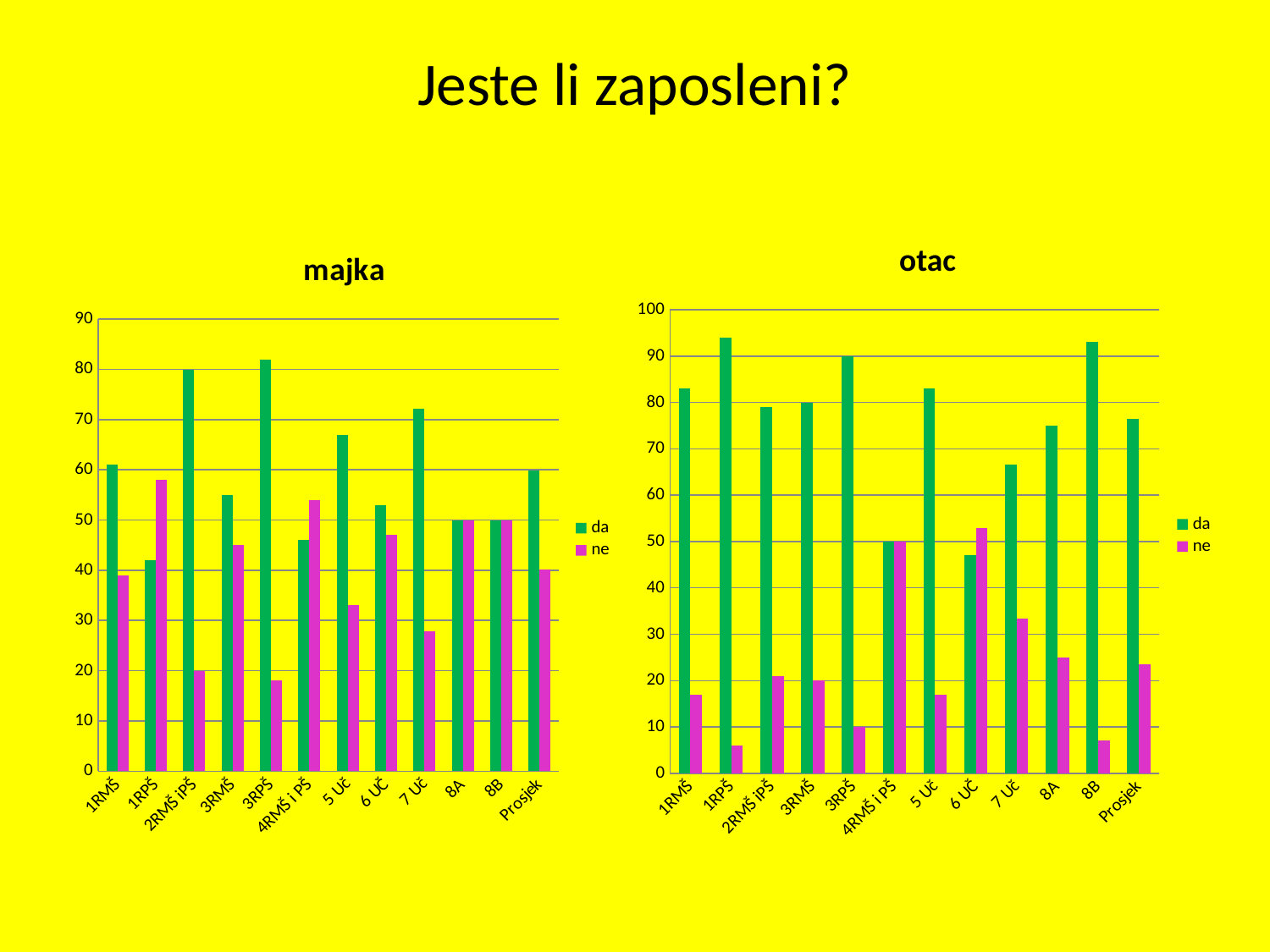
In the 'majka' chart, is the value for 'da' in 5 Uč greater or less than 70? less How many categories are shown on the x axis of the 'otac' chart? 12 How many series does the legend of the 'majka' chart list? 2 In the 'otac' chart, what is the value for 'ne' in the 3RMŠ category? 20 In the 'majka' chart, is the value for 'da' in 1RMŠ greater or less than 50? greater In the 'majka' chart, which is larger for 1RPŠ, 'da' or 'ne'? ne In the 'otac' chart, is the value for 'da' in 1RMŠ greater or less than 80? greater In the 'otac' chart, what is the value for 'da' in the 3RPŠ category? 90 In the 'majka' chart, what is the value for 'da' in the 8A category? 50 What type of chart is the 'otac' chart? bar chart In the 'otac' chart, what is the difference between 'da' and 'ne' for 3RPŠ? 80